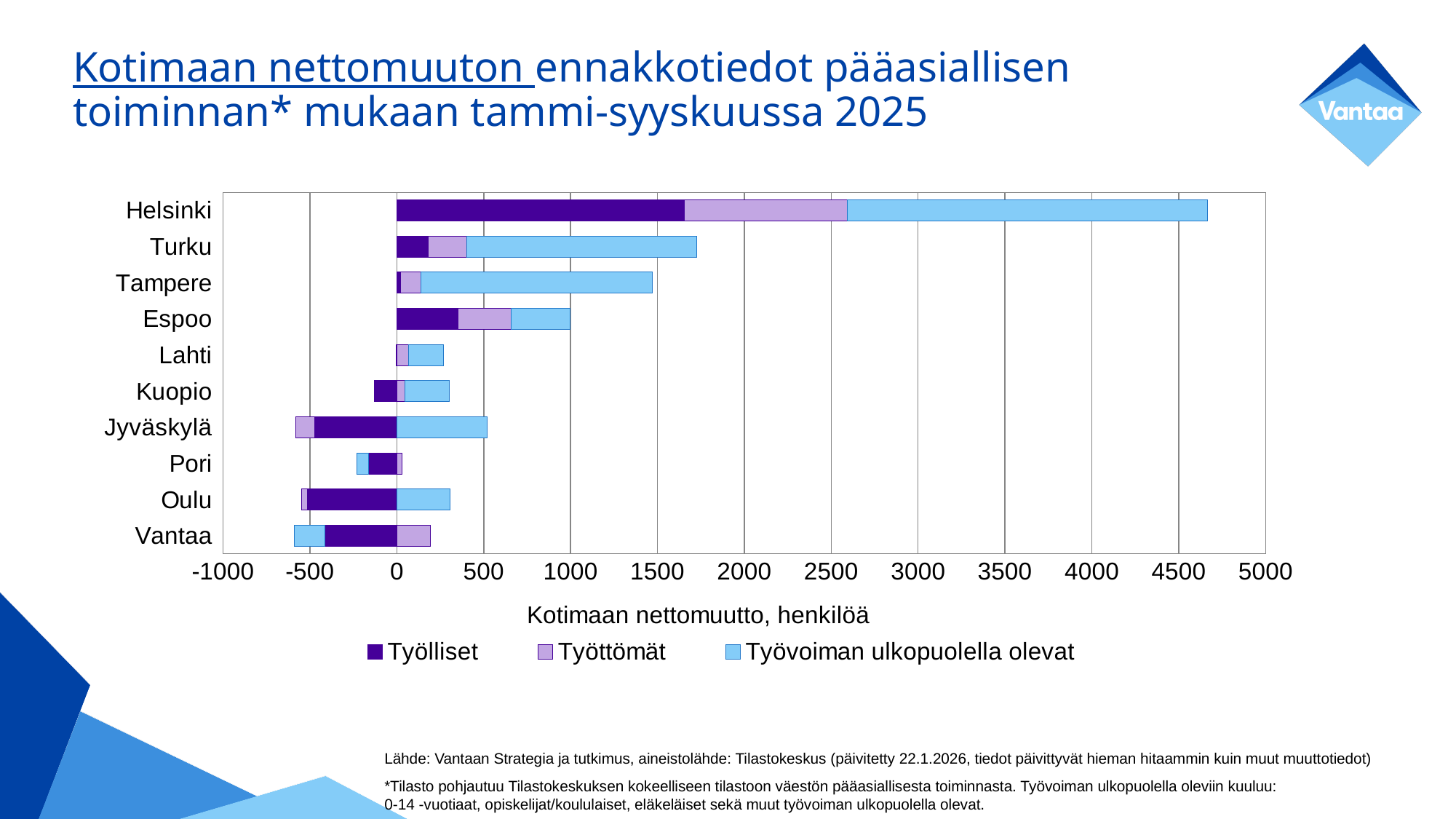
Is the total bar for Tampere greater or less than 1000? greater How many cities are listed on the vertical axis of the chart? 10 Is the total bar for Turku greater or less than 1500? greater Which is larger, the Työlliset segment for Helsinki or the Työlliset segment for Turku? Helsinki How many series does the chart legend list? 3 Is the Työlliset value for Vantaa greater or less than 0? less What kind of chart is shown on the slide? Stacked bar chart What is the title of the horizontal axis of the chart? Kotimaan nettomuutto, henkilöä Which city has the longest total bar in the chart? Helsinki Which legend entry is shown in light blue? Työvoiman ulkopuolella olevat